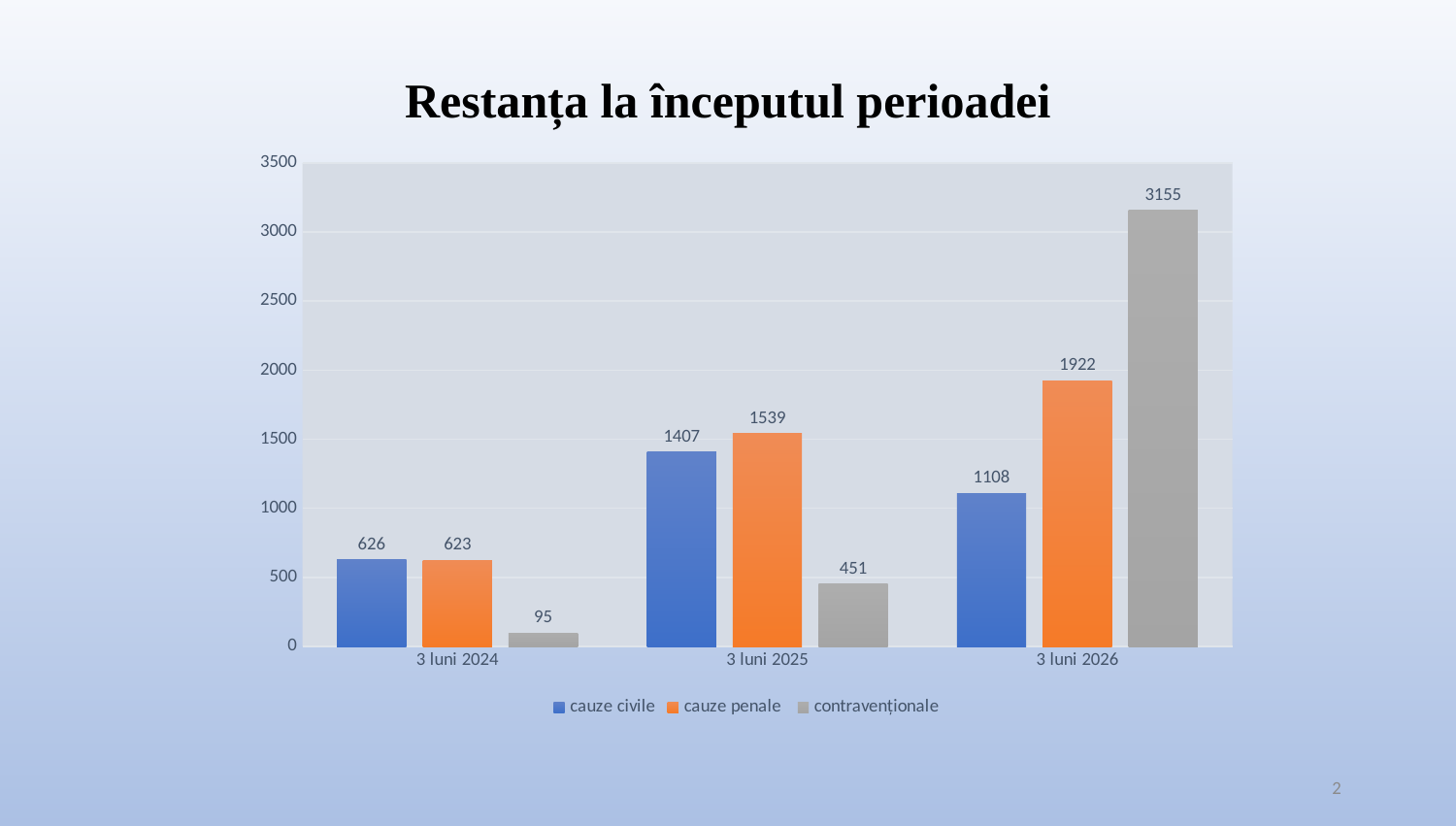
What is the difference between cauze penale and cauze civile in 3 luni 2026? 814 How many periods are shown on the x axis? 3 How many series does the legend list? 3 What is the value for cauze civile in 3 luni 2025? 1407 Is the value for contravenționale in 3 luni 2026 greater or less than 3000? greater Which period has the lowest value for cauze civile? 3 luni 2024 Which period has the highest value for contravenționale? 3 luni 2026 What is the value for contravenționale in 3 luni 2024? 95 What kind of chart is shown on the slide? bar chart What is the title of the chart? Restanța la începutul perioadei What is the value for cauze penale in 3 luni 2026? 1922 Which is larger in 3 luni 2025: cauze civile or cauze penale? cauze penale